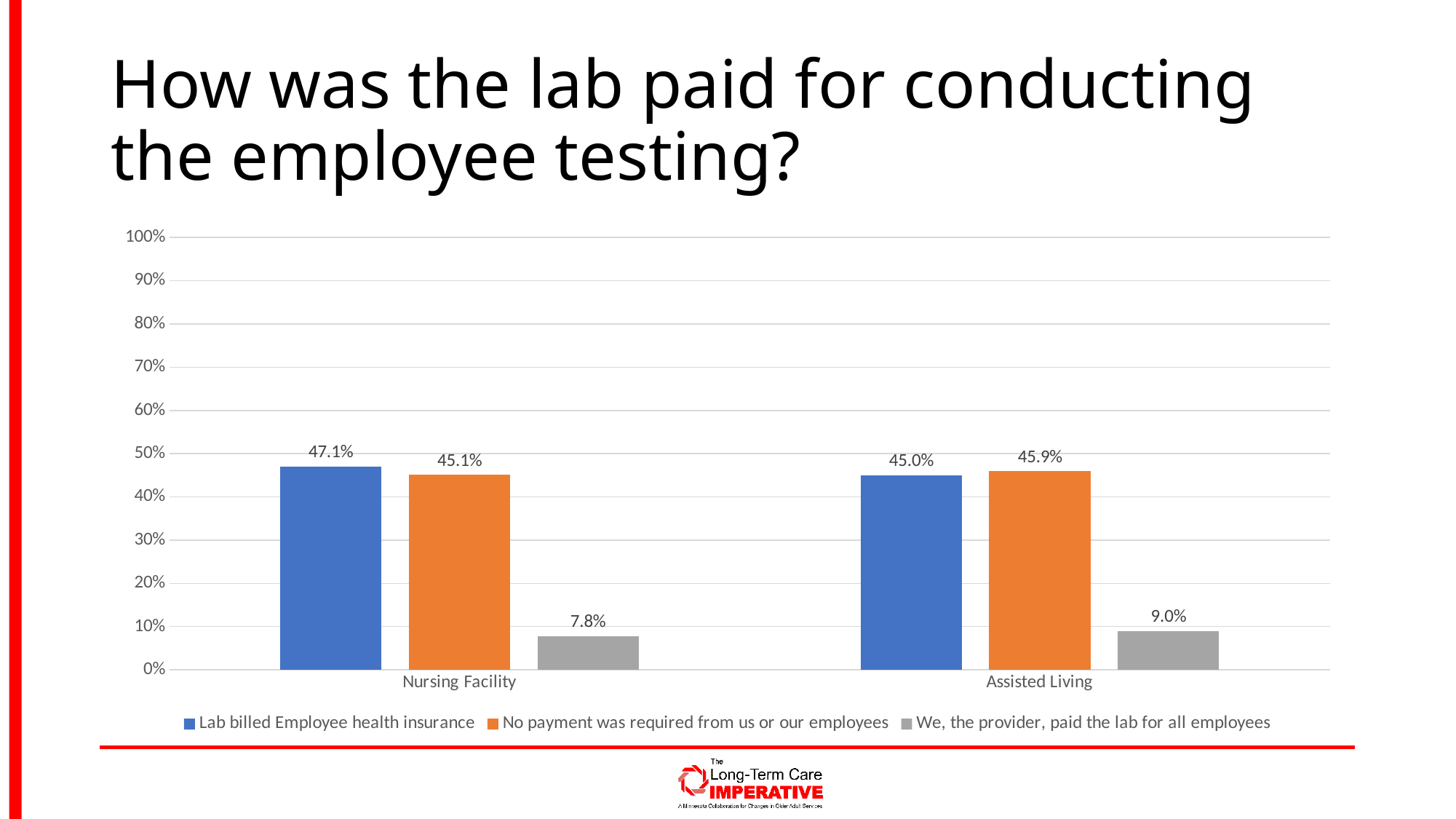
Which is larger for Nursing Facility: 'Lab billed Employee health insurance' or 'No payment was required from us or our employees'? Lab billed Employee health insurance What is the difference between the 'We, the provider, paid the lab for all employees' values for Assisted Living and Nursing Facility? 1.2 percentage points What is the value for 'No payment was required from us or our employees' for Nursing Facility? 45.1% Is the value for 'We, the provider, paid the lab for all employees' in the Nursing Facility group greater or less than 10%? less Which payment method has the highest value in the Assisted Living group? No payment was required from us or our employees What percentage of Nursing Facility respondents said the lab billed employee health insurance? 47.1% What is the difference between the 'Lab billed Employee health insurance' values for Nursing Facility and Assisted Living? 2.1 percentage points What is the value for 'We, the provider, paid the lab for all employees' in the Assisted Living group? 9.0% How many categories are shown on the x axis? 2 Which payment method has the lowest value in the Nursing Facility group? We, the provider, paid the lab for all employees What type of chart is shown on the slide? Bar chart How many series does the legend list? 3